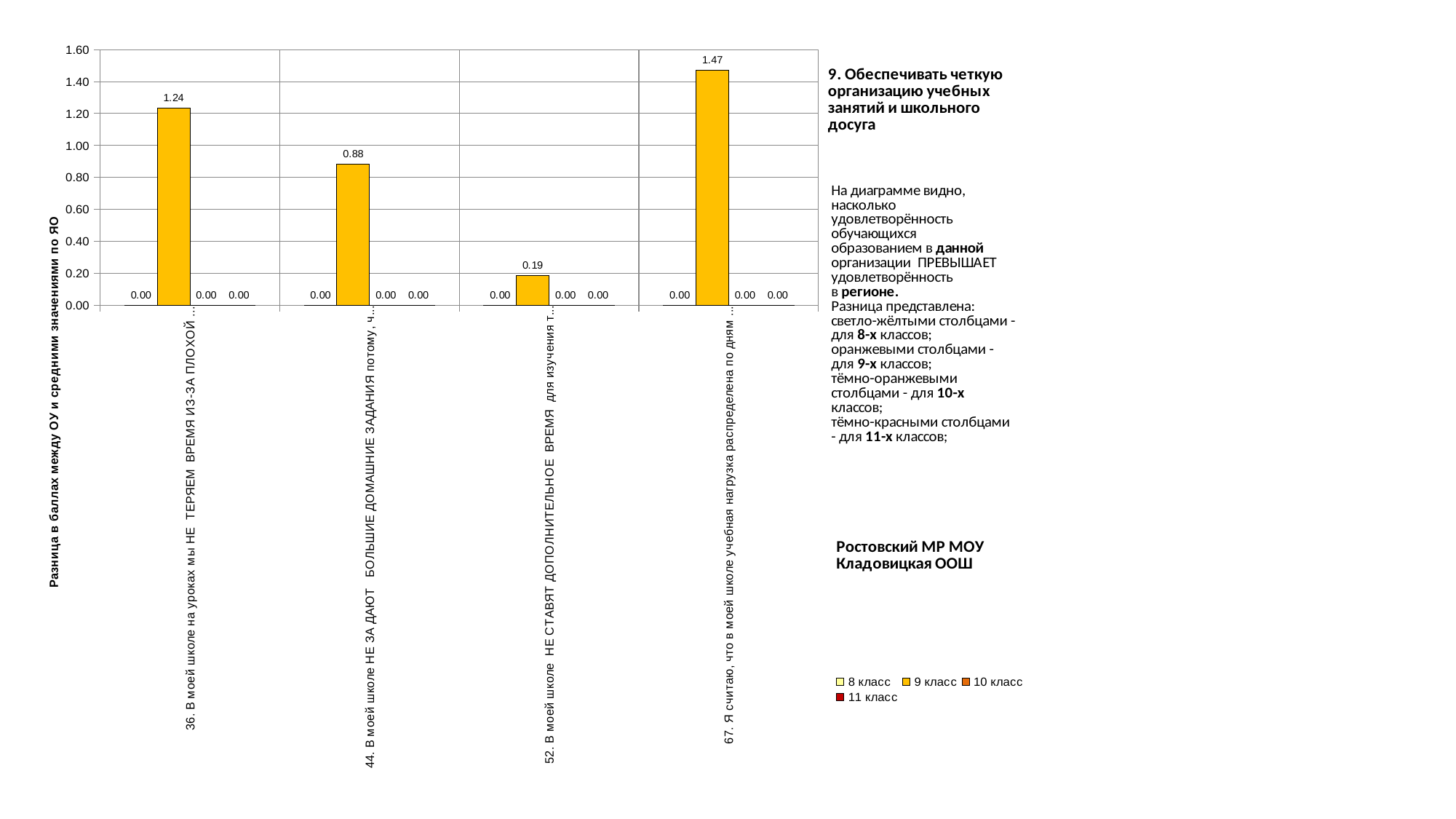
What is the value for 9 класс for statement 36 (В моей школе на уроках мы НЕ ТЕРЯЕМ ВРЕМЯ...)? 1.24 What is the value for 9 класс for statement 44 (В моей школе НЕ ЗАДАЮТ БОЛЬШИЕ ДОМАШНИЕ ЗАДАНИЯ...)? 0.88 For which statement is the 9 класс value the lowest? 52. В моей школе НЕ СТАВЯТ ДОПОЛНИТЕЛЬНОЕ ВРЕМЯ... What is the difference between the 9 класс values for statement 67 and statement 36? 0.23 How many series does the chart legend list? 4 What is the value for 9 класс for statement 52 (В моей школе НЕ СТАВЯТ ДОПОЛНИТЕЛЬНОЕ ВРЕМЯ...)? 0.19 How many statements (categories) are shown on the x axis of the chart? 4 What is the value for 9 класс for statement 67 (Я считаю, что в моей школе учебная нагрузка распределена по дням...)? 1.47 What is the value for 8 класс for statement 36? 0.00 Which is larger for 9 класс: the value for statement 44 or the value for statement 52? Statement 44 For which statement is the 9 класс value the highest? 67. Я считаю, что в моей школе учебная нагрузка распределена по дням... What type of chart is shown on the slide? Bar chart